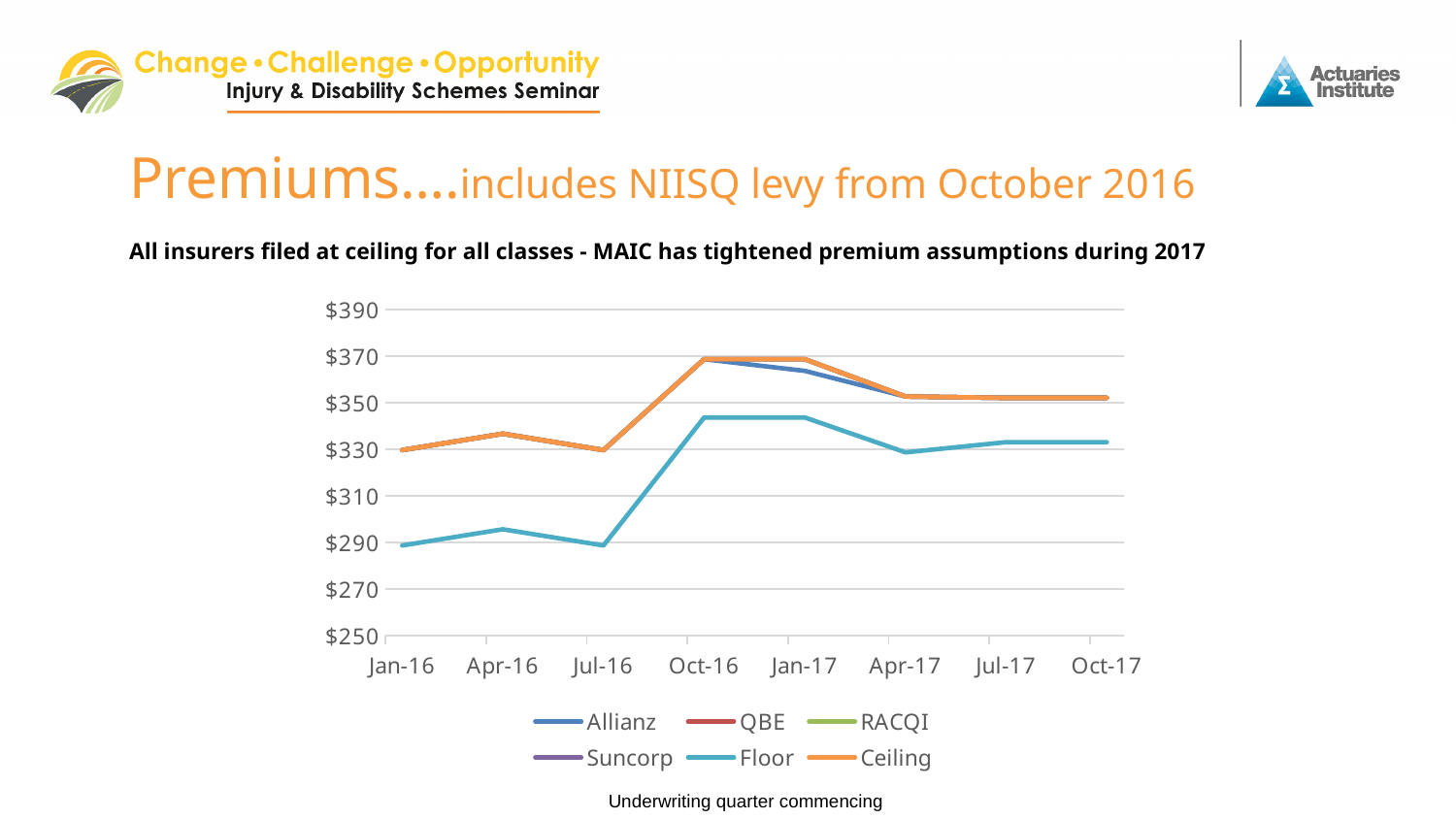
How many series does the legend list? 6 Is the Ceiling value for Oct-16 greater or less than $350? greater Is the Floor value for Oct-17 greater or less than $350? less Does the Floor line rise or fall between Jul-16 and Oct-16? rise What kind of chart is shown on the slide? line chart Is the Ceiling value for Jan-16 greater or less than $350? less How many underwriting quarters are shown along the x axis? 8 What is the label of the x axis? Underwriting quarter commencing Does the Ceiling line rise or fall between Jan-17 and Apr-17? fall Which is larger at Oct-17, the Ceiling value or the Floor value? Ceiling